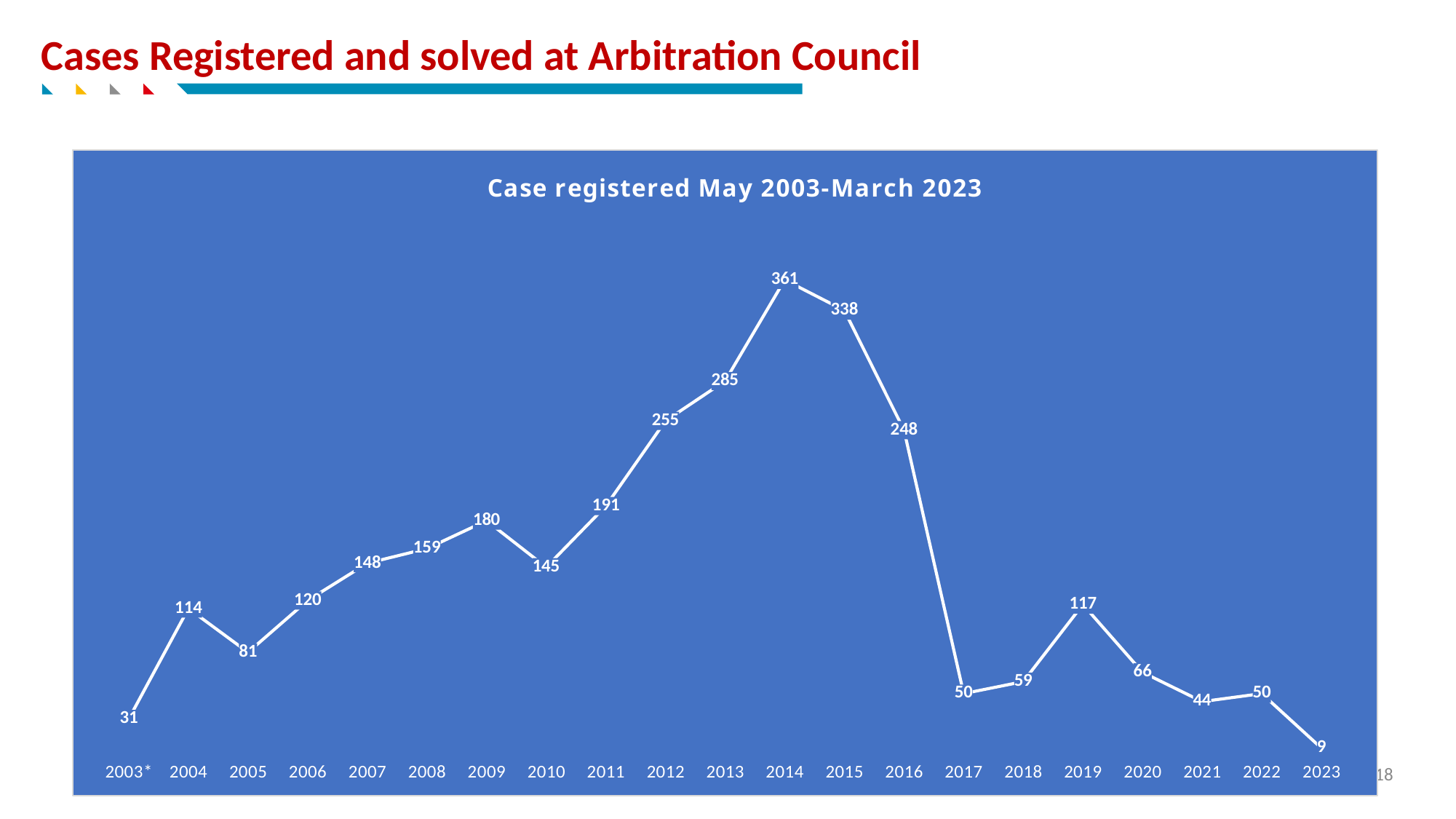
How many cases were registered in 2009? 180 What is the difference between the cases registered in 2014 and 2015? 23 Which year has the lowest number of cases registered? 2023 Do the values rise or fall from 2014 to 2017? Fall How many cases were registered in 2023? 9 What is the difference between the cases registered in 2016 and 2017? 198 Which year has the highest number of cases registered? 2014 Which year had more cases registered, 2019 or 2020? 2019 How many cases were registered in 2014? 361 What type of chart is shown on the slide? Line chart What is the title of the chart? Case registered May 2003-March 2023 How many years (data points) are plotted on the chart? 21